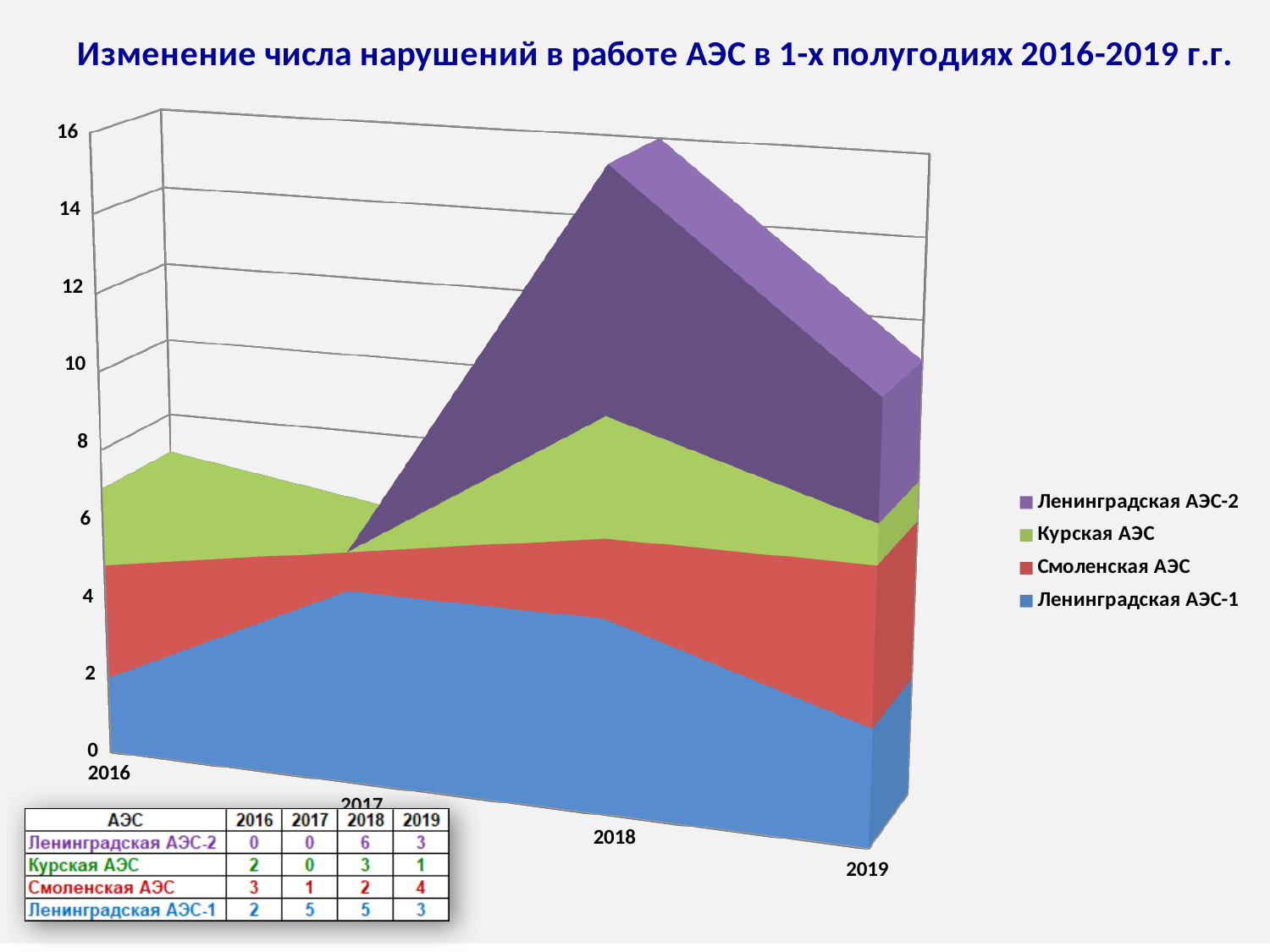
Which is larger: the value for Курская АЭС in 2018 or the value for Курская АЭС in 2019? 2018 What is the value for Смоленская АЭС in 2019? 4 What kind of chart is shown on the slide? stacked area chart What is the difference between the values for Ленинградская АЭС-1 in 2017 and 2016? 3 What is the value for Ленинградская АЭС-1 in 2017? 5 How many years are shown on the x axis? 4 What is the total of all series in 2018? 16 In which year is the value for Смоленская АЭС lowest? 2017 What is the value for Ленинградская АЭС-2 in 2018? 6 In which year is the value for Ленинградская АЭС-2 highest? 2018 How many series does the legend list? 4 What is the value for Курская АЭС in 2016? 2